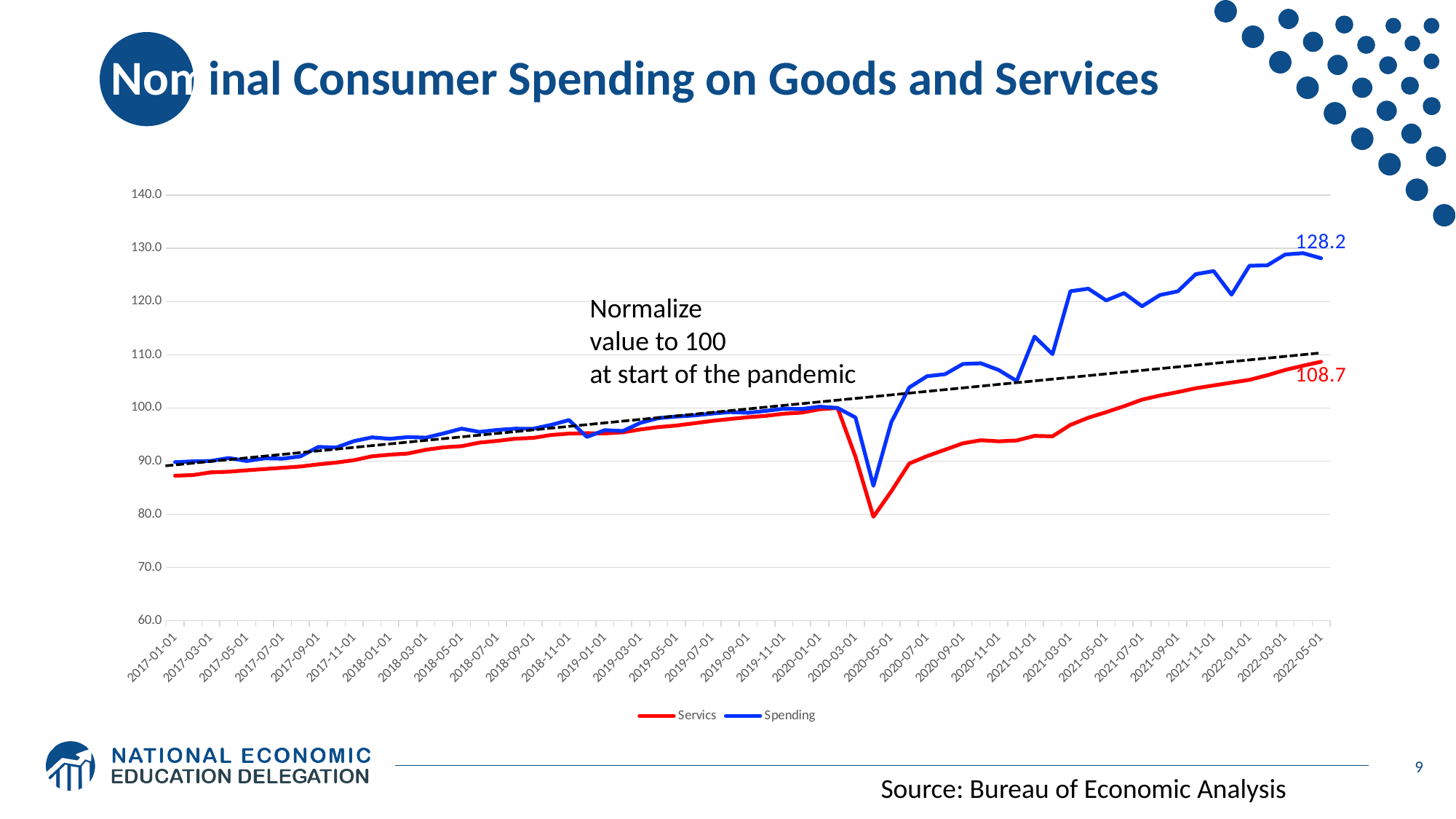
What colour is the Spending line? Blue Is the value for Servics at 2017-01-01 greater or less than 90? less What is the difference between the final labelled values of the Spending and Servics series? 19.5 Is the value for Servics at 2020-05-01 greater or less than 90? less At the end of the chart, which series has the higher value, Spending or Servics? Spending What is the final labelled value of the Servics series? 108.7 How many series does the legend list? 2 What is the final labelled value of the Spending series? 128.2 What kind of chart is shown on the slide? Line chart Over the whole period from 2017-01-01 to 2022-05-01, does the Spending series rise or fall overall? Rise What does the annotation on the chart say the values are normalized to at the start of the pandemic? 100